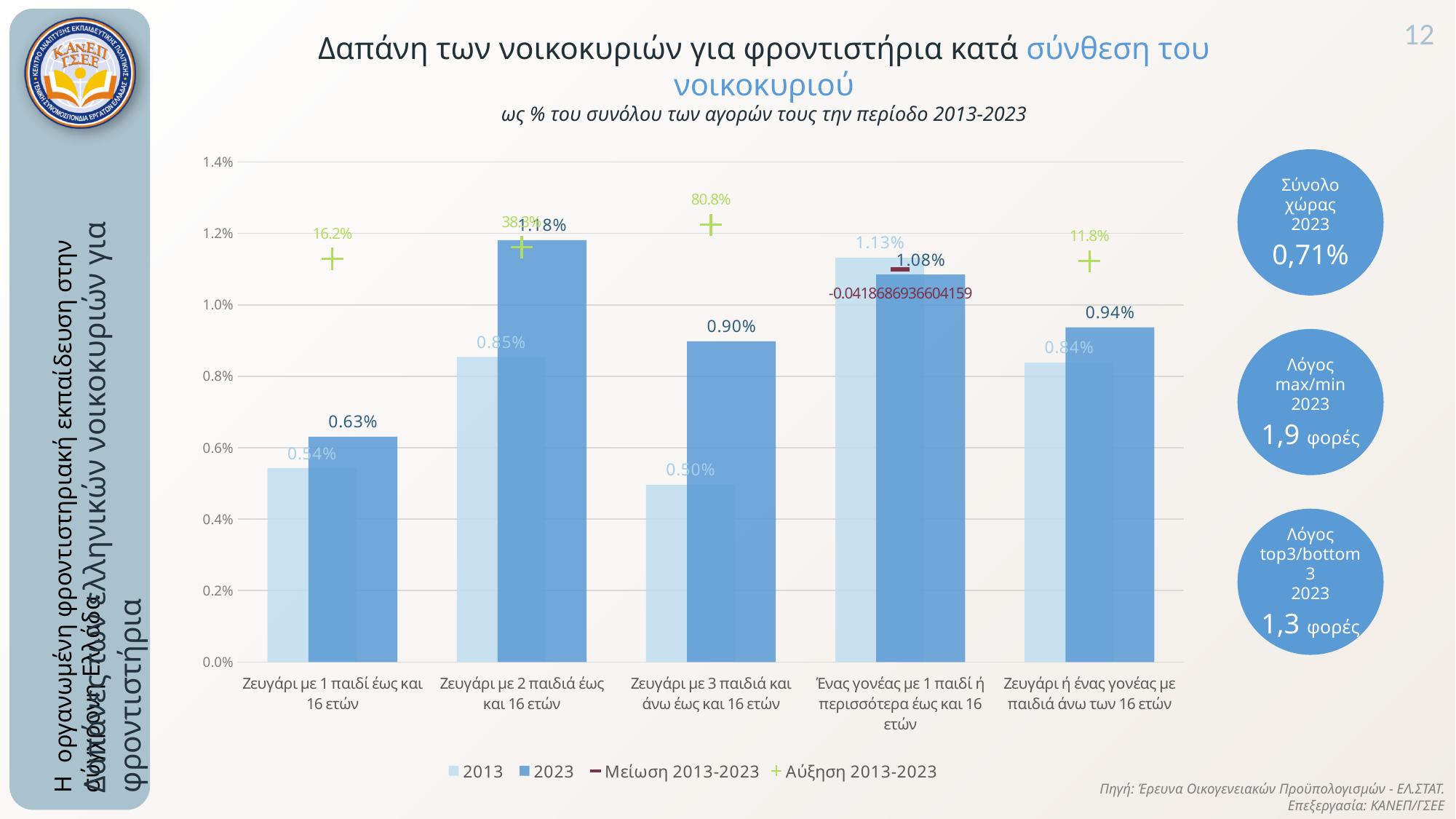
What percentage increase (Αύξηση 2013-2023) is shown for 'Ζευγάρι με 3 παιδιά και άνω έως και 16 ετών'? 80.8% How many entries does the legend list? 4 What was the value for 'Ζευγάρι με 3 παιδιά και άνω έως και 16 ετών' in 2013? 0.50% Which category has the highest value in 2023? Ζευγάρι με 2 παιδιά έως και 16 ετών What is the difference between the 2023 and 2013 values for 'Ζευγάρι με 3 παιδιά και άνω έως και 16 ετών'? 0.40% How many household composition categories are shown on the x axis? 5 What was the value for 'Ένας γονέας με 1 παιδί ή περισσότερα έως και 16 ετών' in 2013? 1.13% Which category has the lowest value in 2013? Ζευγάρι με 3 παιδιά και άνω έως και 16 ετών What type of chart is shown on the slide? Bar chart For 'Ένας γονέας με 1 παιδί ή περισσότερα έως και 16 ετών', which year has the larger value, 2013 or 2023? 2013 What value is shown in the 'Σύνολο χώρας 2023' circle on the right of the slide? 0,71% What was the value for 'Ζευγάρι με 1 παιδί έως και 16 ετών' in 2023? 0.63%